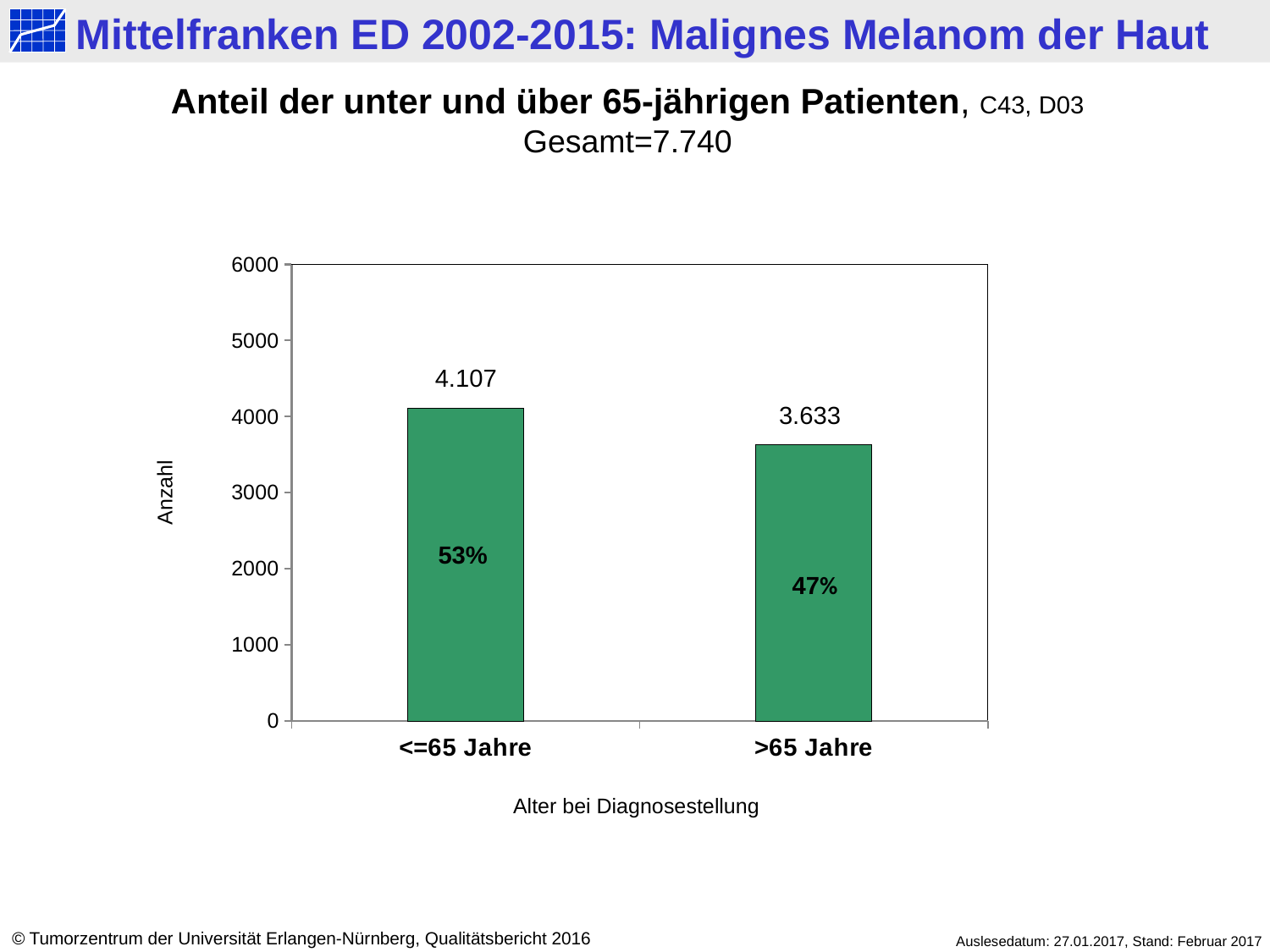
Is the value for <=65 Jahre greater or less than 4000? greater What is the number of patients in the >65 Jahre category? 3.633 What is the difference in patient numbers between the <=65 Jahre and >65 Jahre categories? 474 Which age category has the lower number of patients? >65 Jahre Which age category has the higher number of patients? <=65 Jahre What is the label of the x axis? Alter bei Diagnosestellung Is the value for >65 Jahre greater or less than 4000? less What percentage share is shown on the >65 Jahre bar? 47% What percentage share is shown on the <=65 Jahre bar? 53% How many categories are shown on the x axis? 2 What is the number of patients in the <=65 Jahre category? 4.107 What kind of chart is shown on the slide? bar chart